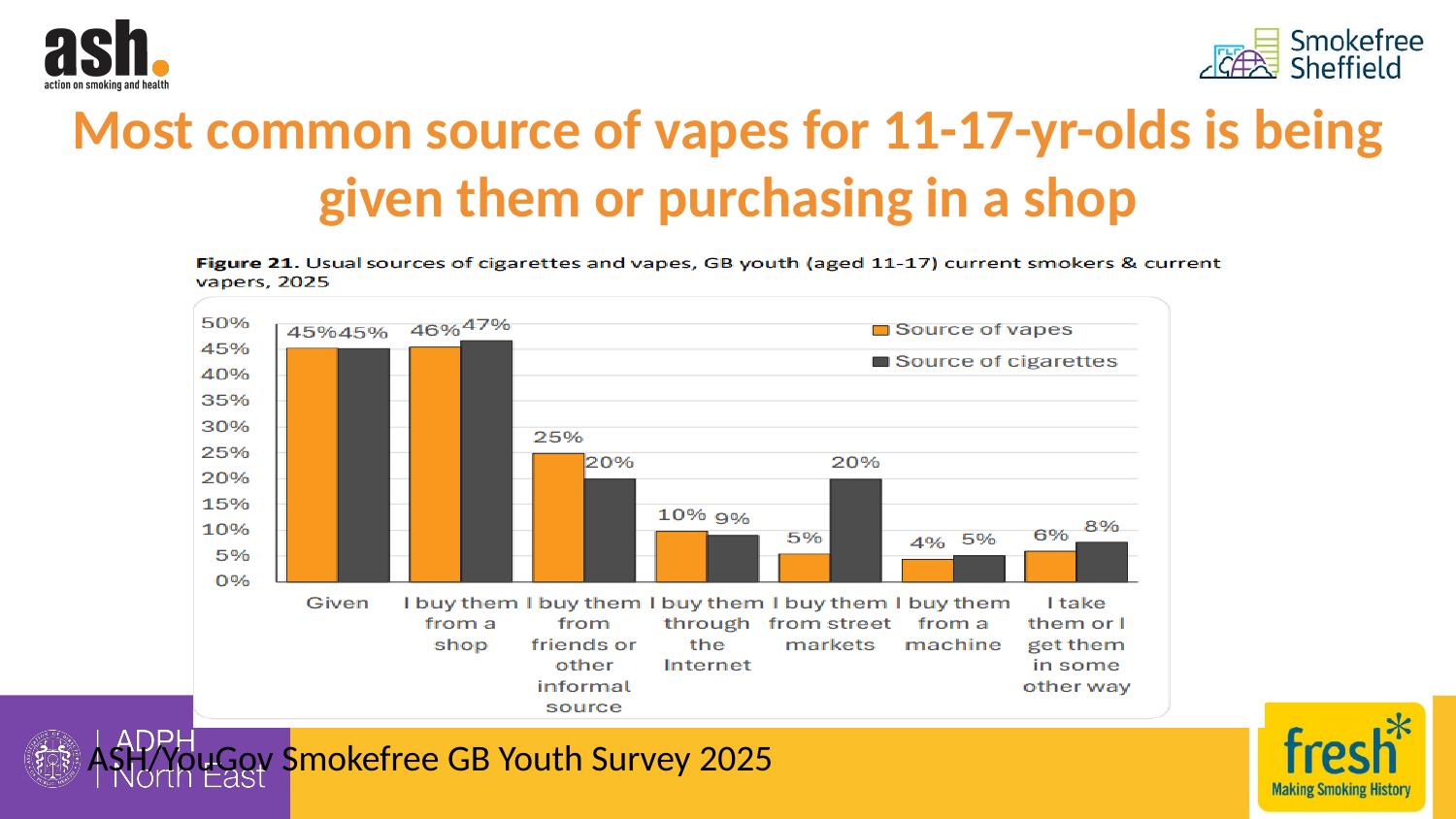
Which category has the lowest value for 'Source of vapes'? I buy them from a machine How many source categories are shown on the x axis? 7 How many series does the legend list? 2 What percentage of current vapers say they buy vapes from a shop? 46% What is the value for 'Source of vapes' in the 'Given' category? 45% For 'I buy them through the Internet', which is larger: the 'Source of vapes' value or the 'Source of cigarettes' value? Source of vapes What kind of chart is shown on the slide? Bar chart Which category has the highest value for 'Source of cigarettes'? I buy them from a shop What is the value for 'Source of cigarettes' in the 'I buy them from street markets' category? 20% Which colour represents 'Source of vapes' in the chart? Orange What percentage is shown for 'Source of vapes' in the 'I buy them from friends or other informal source' category? 25% What is the difference between the 'Source of cigarettes' and 'Source of vapes' values for 'I buy them from street markets'? 15%